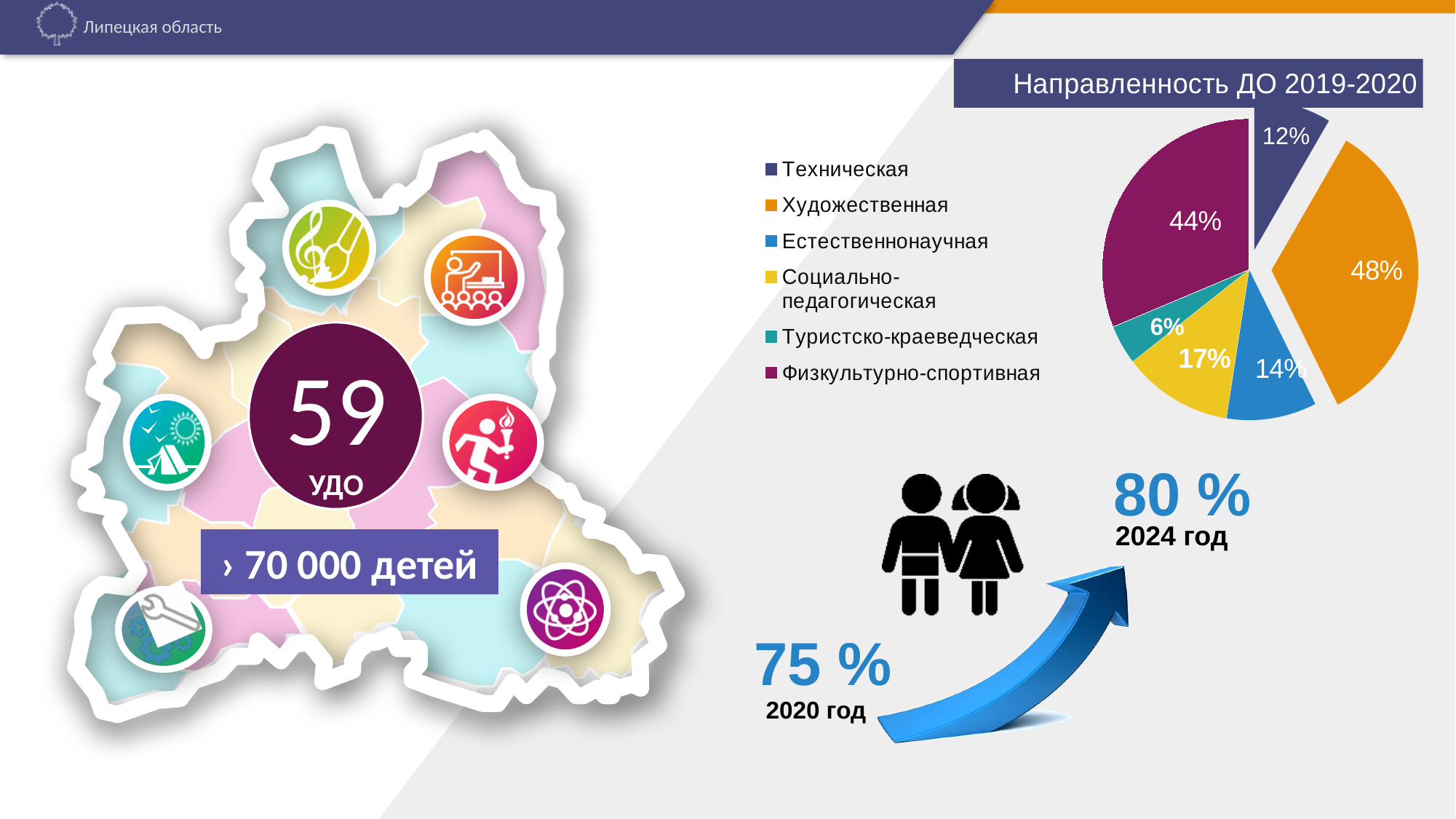
In the pie chart, what is the difference between the values for Художественная and Физкультурно-спортивная? 4% What kind of chart is shown under the title "Направленность ДО 2019-2020"? pie chart How many categories does the pie chart's legend list? 6 What is the title of the pie chart? Направленность ДО 2019-2020 In the pie chart, what is the value for Физкультурно-спортивная? 44% In the pie chart, what is the value for Туристско-краеведческая? 6% In the pie chart, which is larger: Социально-педагогическая or Естественнонаучная? Социально-педагогическая In the pie chart, what is the value for Социально-педагогическая? 17% Which category has the smallest slice in the pie chart? Туристско-краеведческая Which category has the largest slice in the pie chart? Художественная In the pie chart, what is the value for Художественная? 48% In the pie chart, what is the value for Техническая? 12%